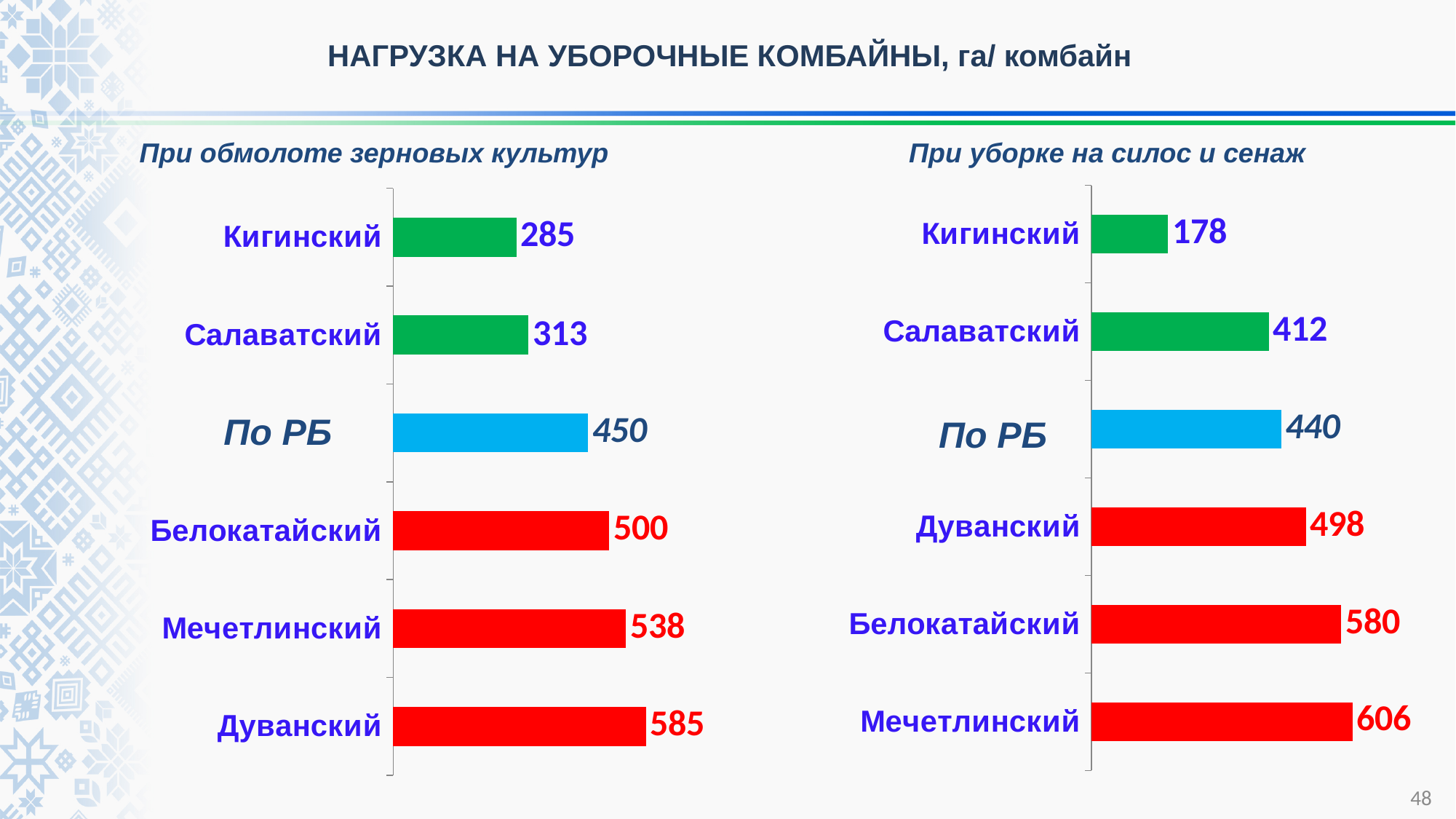
In the left chart 'При обмолоте зерновых культур', which is larger: Мечетлинский or Белокатайский? Мечетлинский How many categories are shown in the left chart 'При обмолоте зерновых культур'? 6 What type of chart is used on the slide? Bar chart In the right chart 'При уборке на силос и сенаж', what is the difference between Белокатайский and По РБ? 140 In the right chart 'При уборке на силос и сенаж', which category has the lowest value? Кигинский In the left chart 'При обмолоте зерновых культур', what is the value for По РБ? 450 In the right chart 'При уборке на силос и сенаж', which is larger: Дуванский or Салаватский? Дуванский In the left chart 'При обмолоте зерновых культур', which category has the highest value? Дуванский In the left chart 'При обмолоте зерновых культур', what is the difference between Дуванский and Кигинский? 300 In the right chart 'При уборке на силос и сенаж', what is the value for Салаватский? 412 In the left chart 'При обмолоте зерновых культур', what is the value for Кигинский? 285 In the right chart 'При уборке на силос и сенаж', which category has the highest value? Мечетлинский